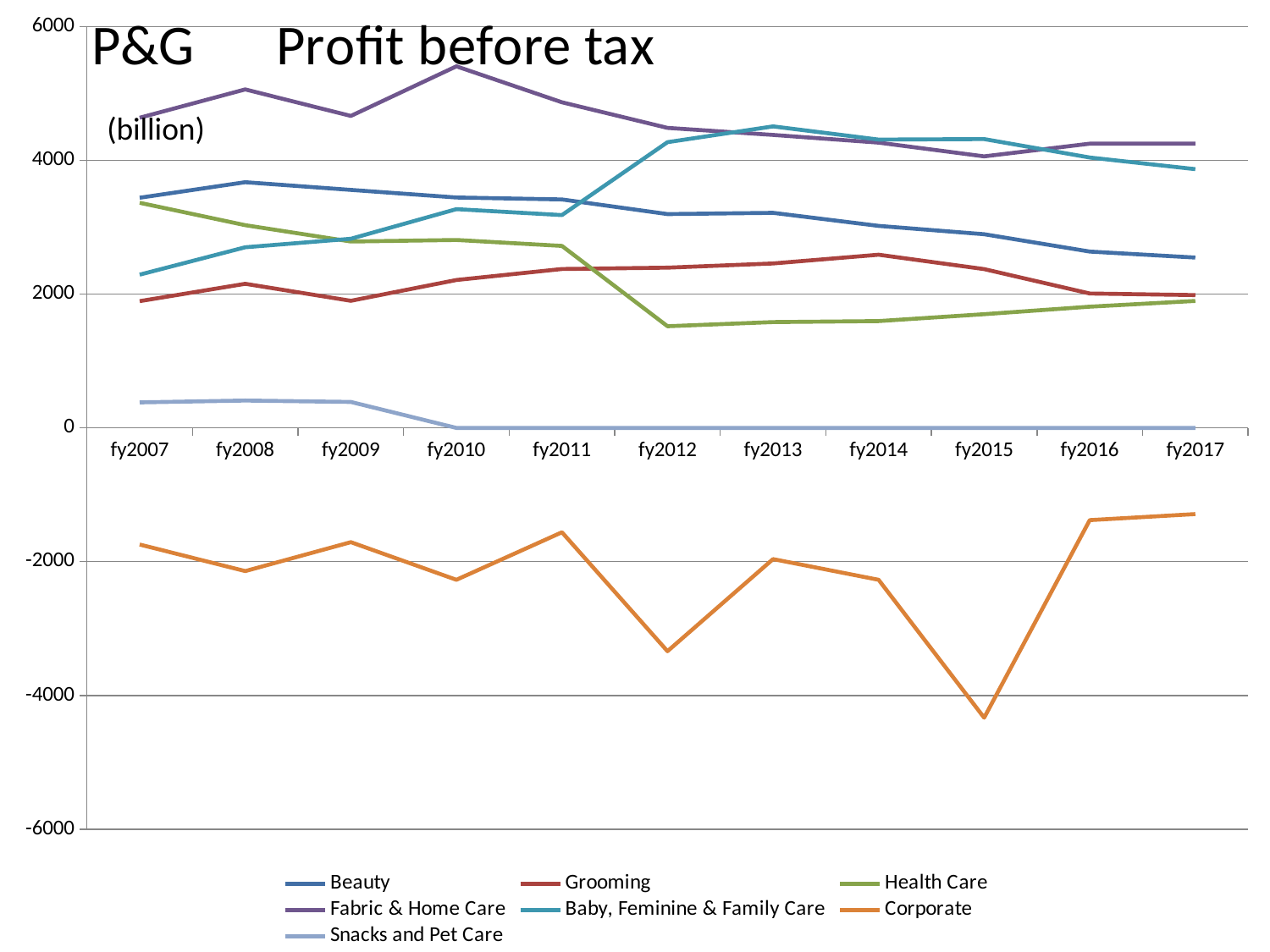
How many series does the legend list? 7 In fy2017, which is larger: Baby, Feminine & Family Care or Beauty? Baby, Feminine & Family Care How many fiscal years are shown on the x axis? 11 Is the value for Fabric & Home Care in fy2010 greater or less than 4000? greater Which series has the lowest value in fy2012? Corporate Is the value for Health Care in fy2012 greater or less than 2000? less What is the value for Snacks and Pet Care in fy2015? 0 What kind of chart is shown on the slide? line chart Does the Beauty series rise or fall from fy2008 to fy2017? fall Which series has the highest value in fy2007? Fabric & Home Care Is the value for Corporate in fy2015 greater or less than -4000? less